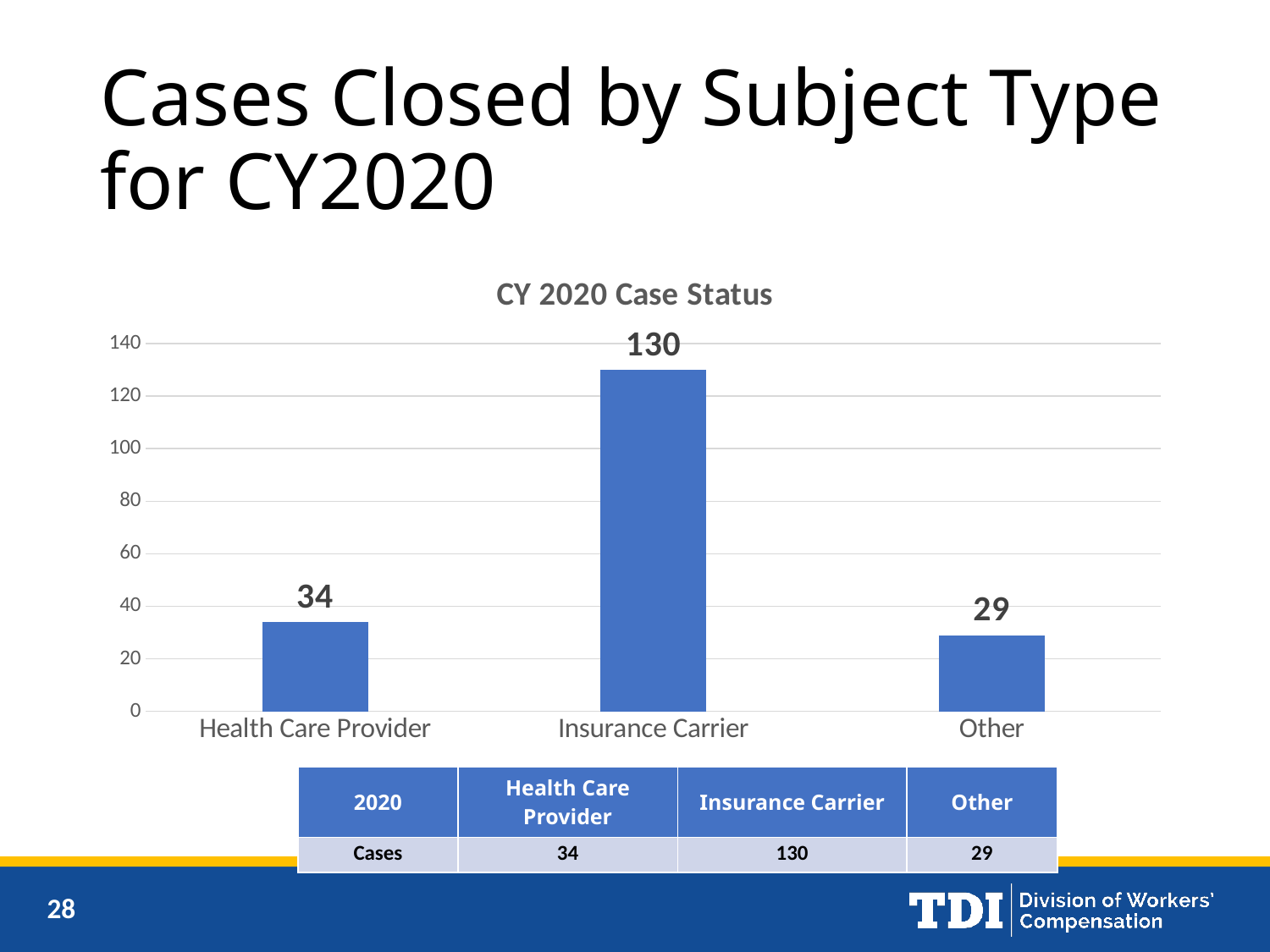
What is the number of cases for Insurance Carrier? 130 How many categories are shown on the x axis? 3 Which has more cases, Health Care Provider or Other? Health Care Provider What is the difference in cases between Insurance Carrier and Health Care Provider? 96 What kind of chart is shown on the slide? Bar chart What is the title of the chart? CY 2020 Case Status What is the number of cases for Health Care Provider? 34 Which category has the highest number of cases? Insurance Carrier Which category has the lowest number of cases? Other Is the value for Insurance Carrier greater or less than 100? greater What is the difference in cases between Health Care Provider and Other? 5 What is the number of cases for Other? 29